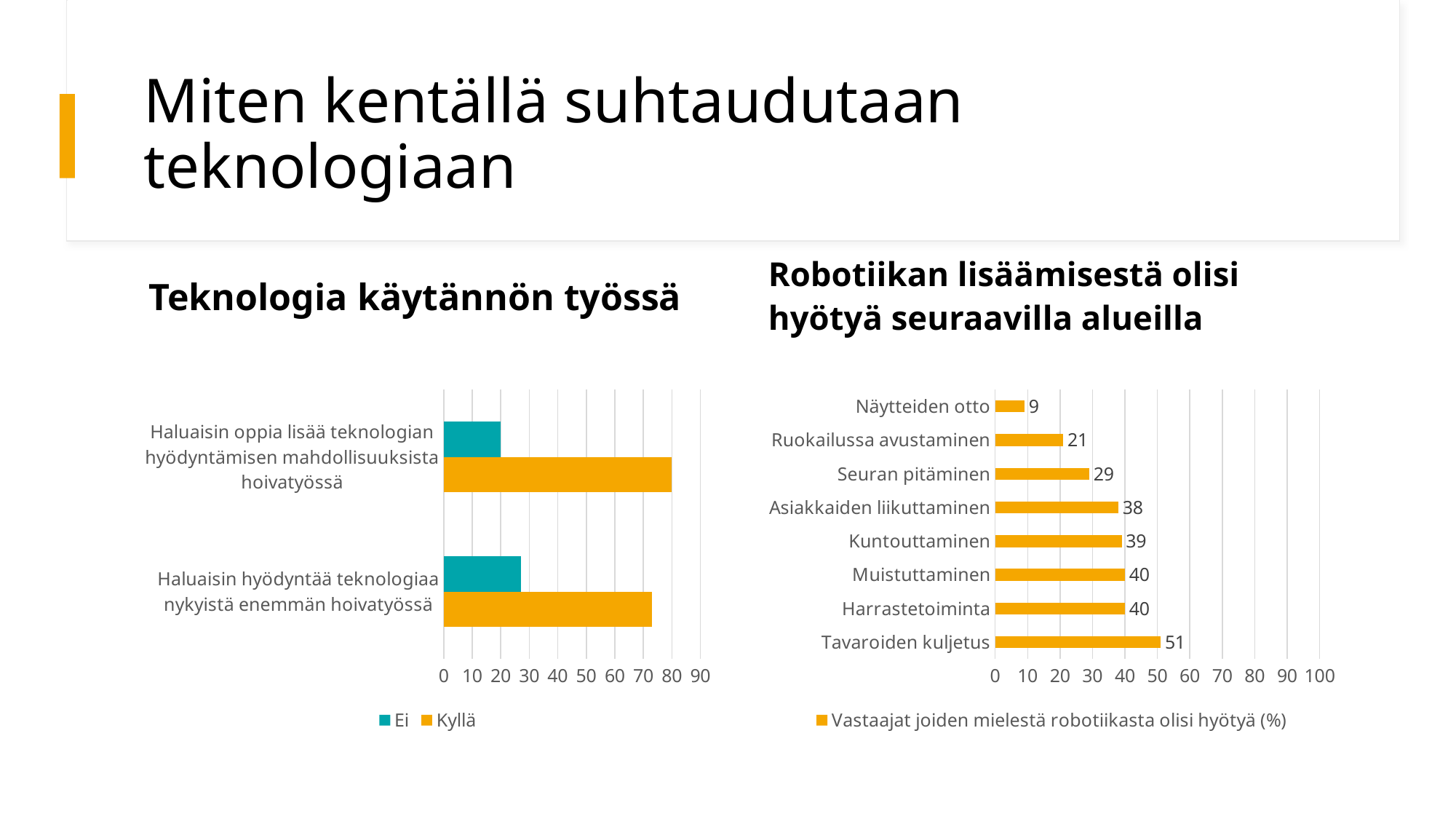
In the chart titled "Robotiikan lisäämisestä olisi hyötyä seuraavilla alueilla", which category has the highest value? Tavaroiden kuljetus In the chart titled "Teknologia käytännön työssä", for "Haluaisin hyödyntää teknologiaa nykyistä enemmän hoivatyössä", which series has the larger value: Ei or Kyllä? Kyllä In the chart titled "Robotiikan lisäämisestä olisi hyötyä seuraavilla alueilla", what is the difference between the values for Tavaroiden kuljetus and Näytteiden otto? 42 In the chart titled "Teknologia käytännön työssä", is the Ei value for "Haluaisin hyödyntää teknologiaa nykyistä enemmän hoivatyössä" greater or less than 40? less In the chart titled "Robotiikan lisäämisestä olisi hyötyä seuraavilla alueilla", what is the value for Asiakkaiden liikuttaminen? 38 How many categories are shown in the chart titled "Robotiikan lisäämisestä olisi hyötyä seuraavilla alueilla"? 8 In the chart titled "Robotiikan lisäämisestä olisi hyötyä seuraavilla alueilla", which category has the lowest value? Näytteiden otto How many series does the legend of the chart titled "Teknologia käytännön työssä" list? 2 In the chart titled "Robotiikan lisäämisestä olisi hyötyä seuraavilla alueilla", which is larger: Seuran pitäminen or Ruokailussa avustaminen? Seuran pitäminen In the chart titled "Robotiikan lisäämisestä olisi hyötyä seuraavilla alueilla", what is the value for Tavaroiden kuljetus? 51 What kind of chart is the chart titled "Teknologia käytännön työssä"? Bar chart In the chart titled "Teknologia käytännön työssä", is the Kyllä value for "Haluaisin oppia lisää teknologian hyödyntämisen mahdollisuuksista hoivatyössä" greater or less than 70? greater